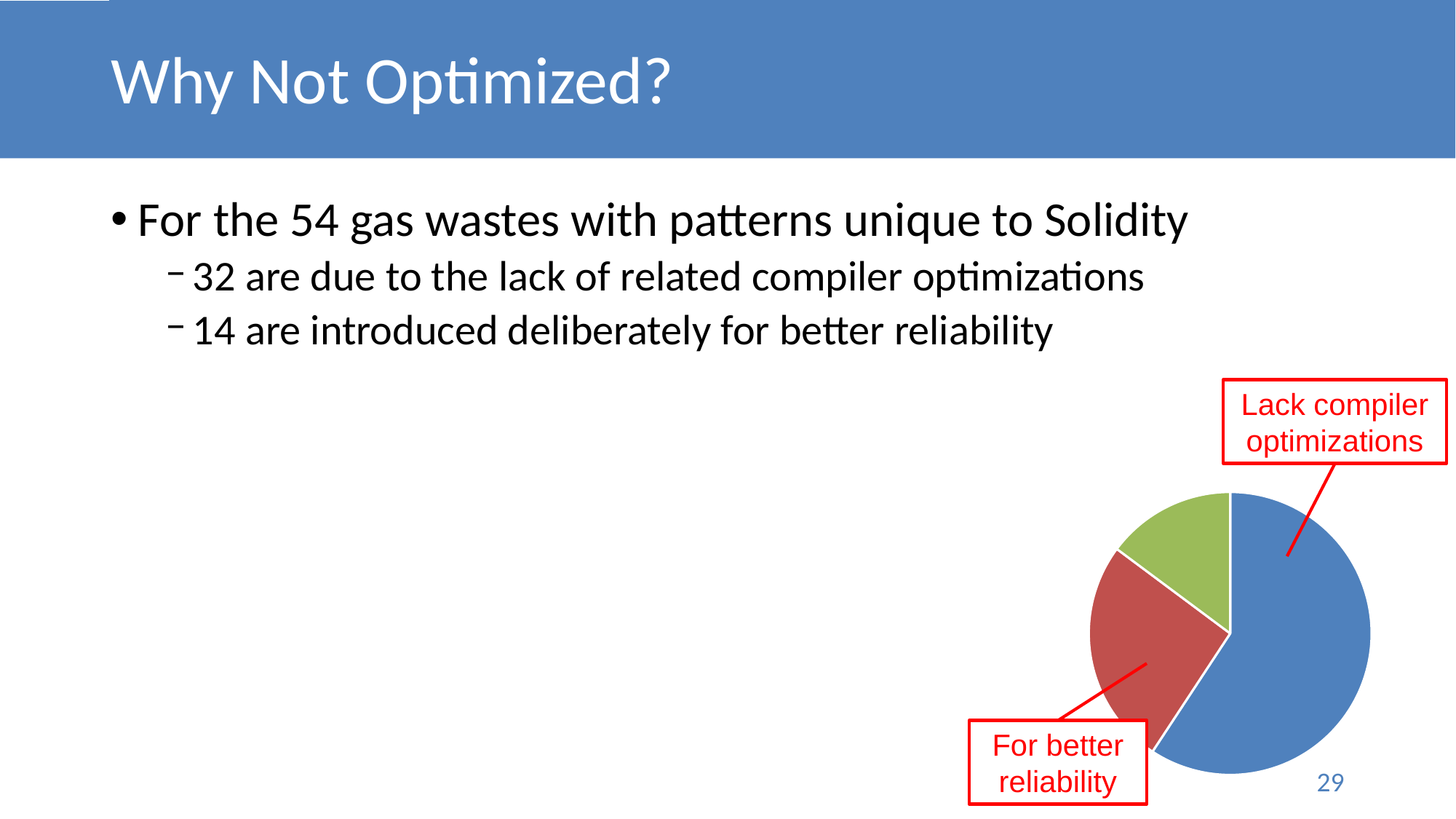
What kind of chart is shown on the slide? pie chart How many slices of the pie chart have a text label attached? 2 How many slices does the pie chart have? 3 Which is larger in the pie chart, the slice for Lack compiler optimizations or the slice for For better reliability? Lack compiler optimizations Which slice of the pie chart is the largest? Lack compiler optimizations What colour is the For better reliability slice in the pie chart? red Does the Lack compiler optimizations slice take up more or less than half of the pie? more What colour is the Lack compiler optimizations slice in the pie chart? blue